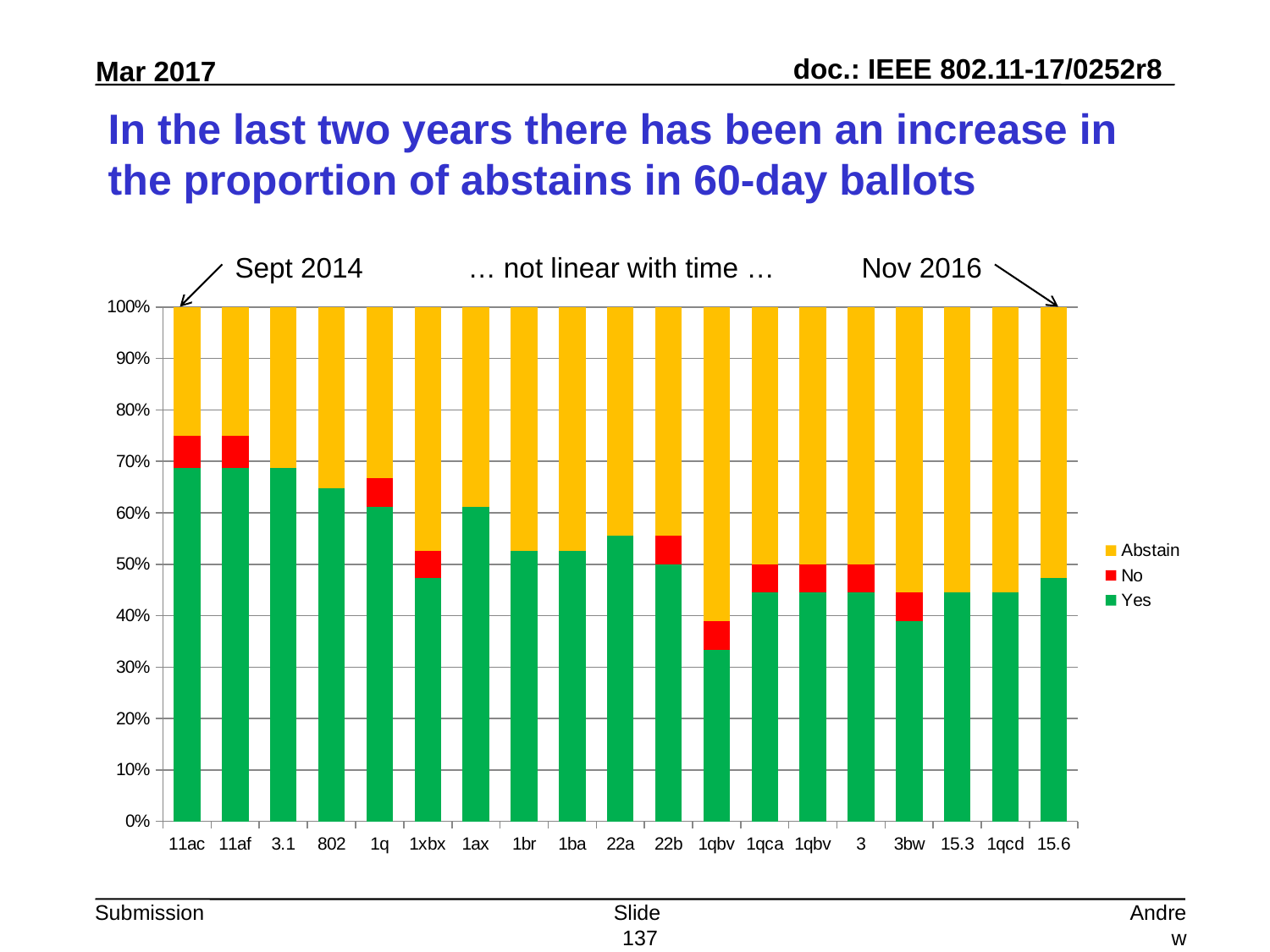
What kind of chart is shown on the slide? Stacked bar chart Which colour represents the Abstain series? Yellow Is the Yes value for 3bw greater or less than 50%? less How many series does the legend list? 3 Is the Yes value for 802 greater or less than 60%? greater Which has the larger Yes proportion, 11ac or 3bw? 11ac Is the Yes value for 15.6 greater or less than 50%? less Does the Yes proportion generally rise or fall moving from left to right along the x axis? Fall How many categories are shown along the x axis? 19 Which series are listed in the legend? Abstain, No, Yes Which has the larger Yes proportion, 802 or 15.3? 802